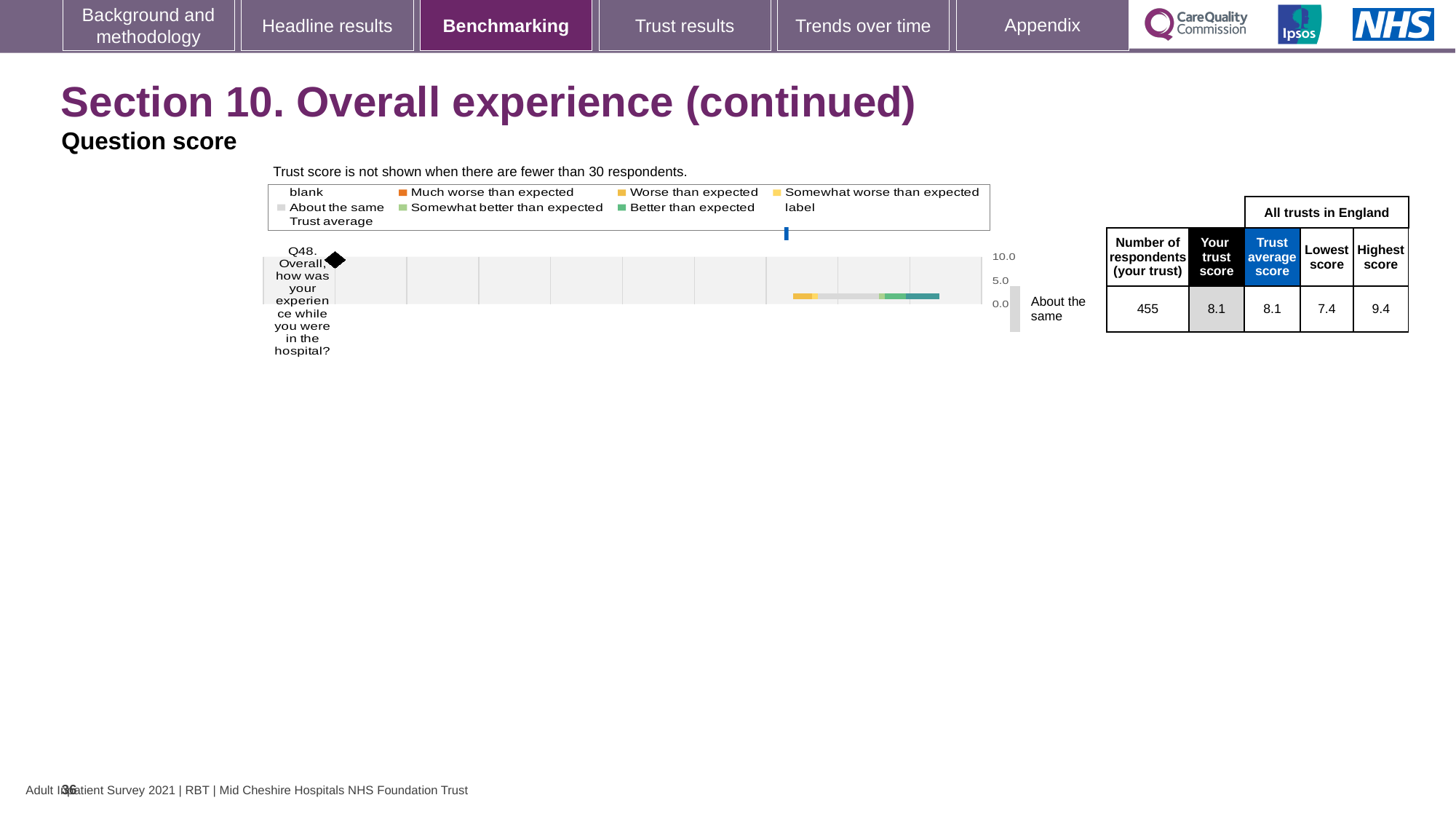
What is your trust score for Q48 according to the table beside the chart? 8.1 What is the highest score among all trusts in England for Q48? 9.4 What is the trust average score for Q48? 8.1 How many respondents from your trust answered Q48? 455 Is your trust score for Q48 greater or less than 5.0 on the chart's axis? greater What is the lowest score among all trusts in England for Q48? 7.4 What benchmark category is shown to the right of the Q48 bar? About the same Which question is plotted in the benchmarking chart? Q48. Overall, how was your experience while you were in the hospital? Is your trust score for Q48 higher than, lower than, or the same as the trust average score? the same How many survey questions are plotted in the benchmarking chart? 1 What is the difference between the highest and lowest scores for Q48 across all trusts in England? 2.0 What kind of chart is used to show the Q48 benchmarking result? bar chart